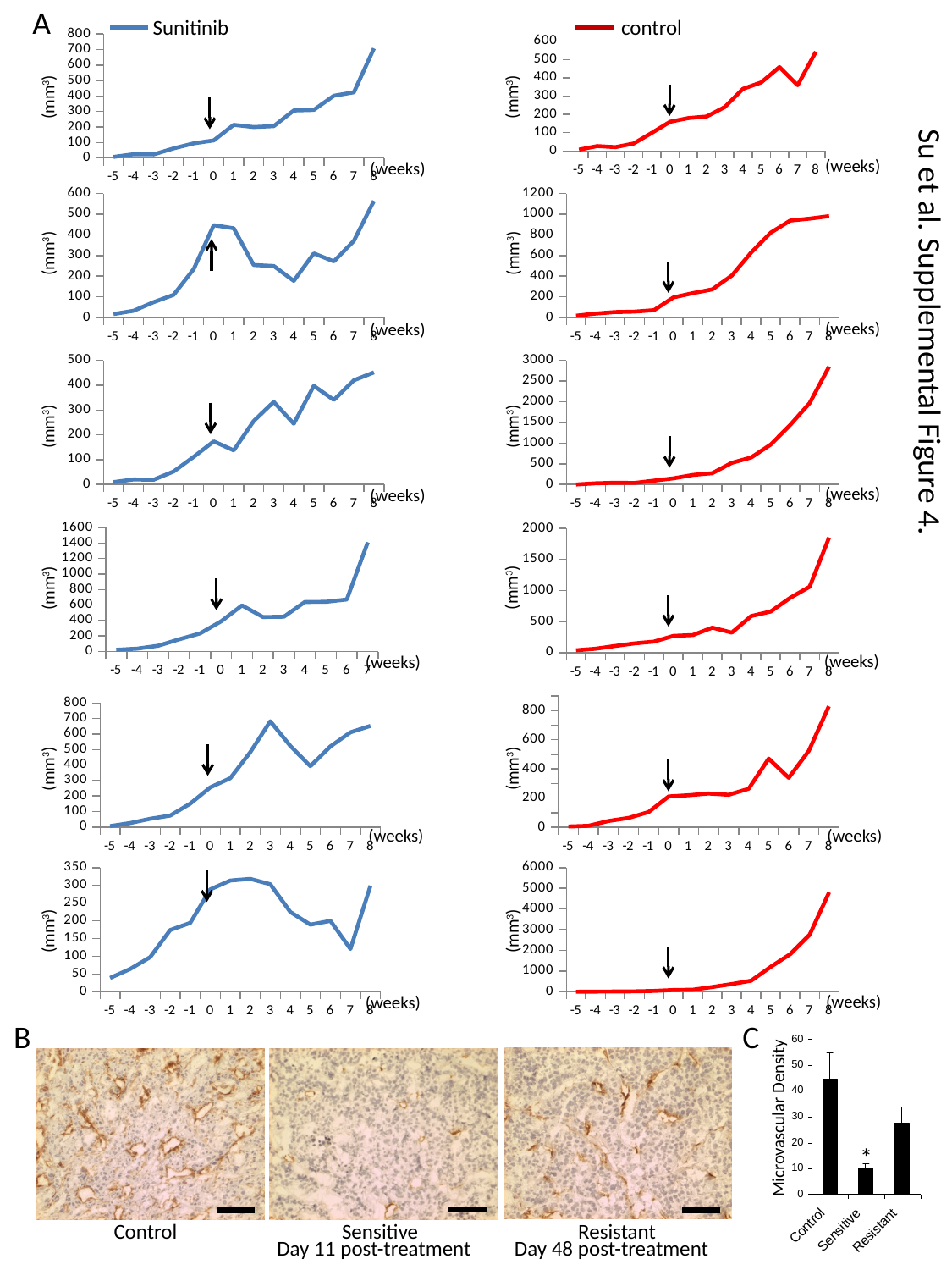
What kind of charts are shown in panel A? line charts In panel C (Microvascular Density), which category has the lowest bar? Sensitive How many line charts are shown in panel A? 12 In panel C (Microvascular Density), how many categories are shown on the x axis? 3 In panel C (Microvascular Density), which is larger, the value for Resistant or the value for Sensitive? Resistant In panel A, what are the two legend entries shown at the top of the columns of charts? Sunitinib and control In panel C (Microvascular Density), is the value for Sensitive greater or less than 20? less What kind of chart is panel C (Microvascular Density)? bar chart In the top-left Sunitinib chart of panel A (y axis up to 800), is the value at week 8 greater or less than 600? greater In panel C (Microvascular Density), is the value for Control greater or less than 40? greater In panel C (Microvascular Density), which category has the highest bar? Control